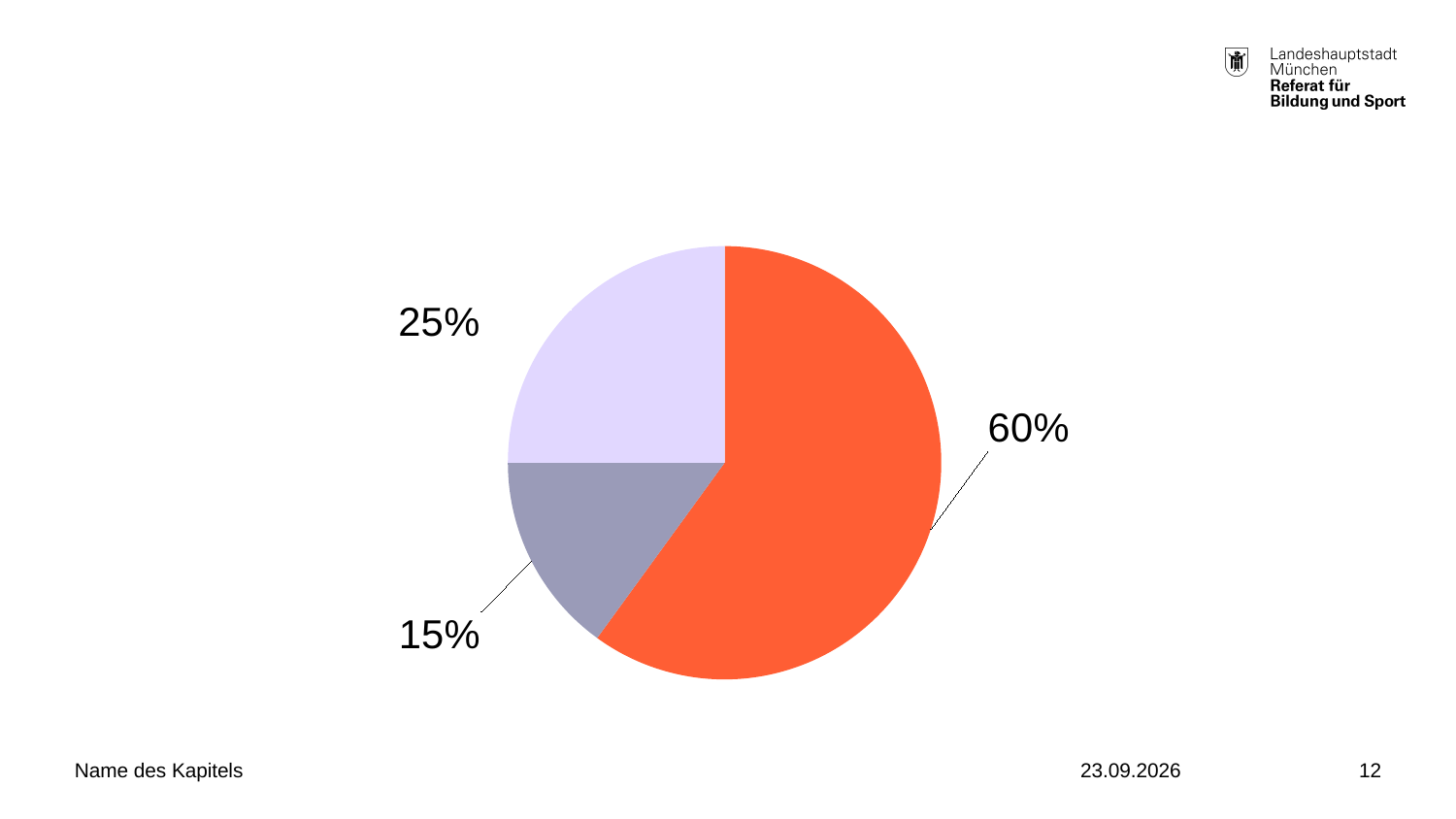
What kind of chart is shown on the slide? pie chart How many slices does the pie chart have? 3 Is the orange-red slice more or less than half of the pie? more What is the difference between the light lavender slice and the grey-purple slice? 10% What share of the pie does the light lavender slice represent? 25% Which slice of the pie chart is the largest? the orange-red slice (60%) Which slice of the pie chart is the smallest? the grey-purple slice (15%) What is the difference between the largest slice and the smallest slice of the pie chart? 45% Does the pie chart have a legend? No Which is larger, the light lavender slice or the grey-purple slice? the light lavender slice What share of the pie does the grey-purple slice represent? 15% What share of the pie does the orange-red slice represent? 60%